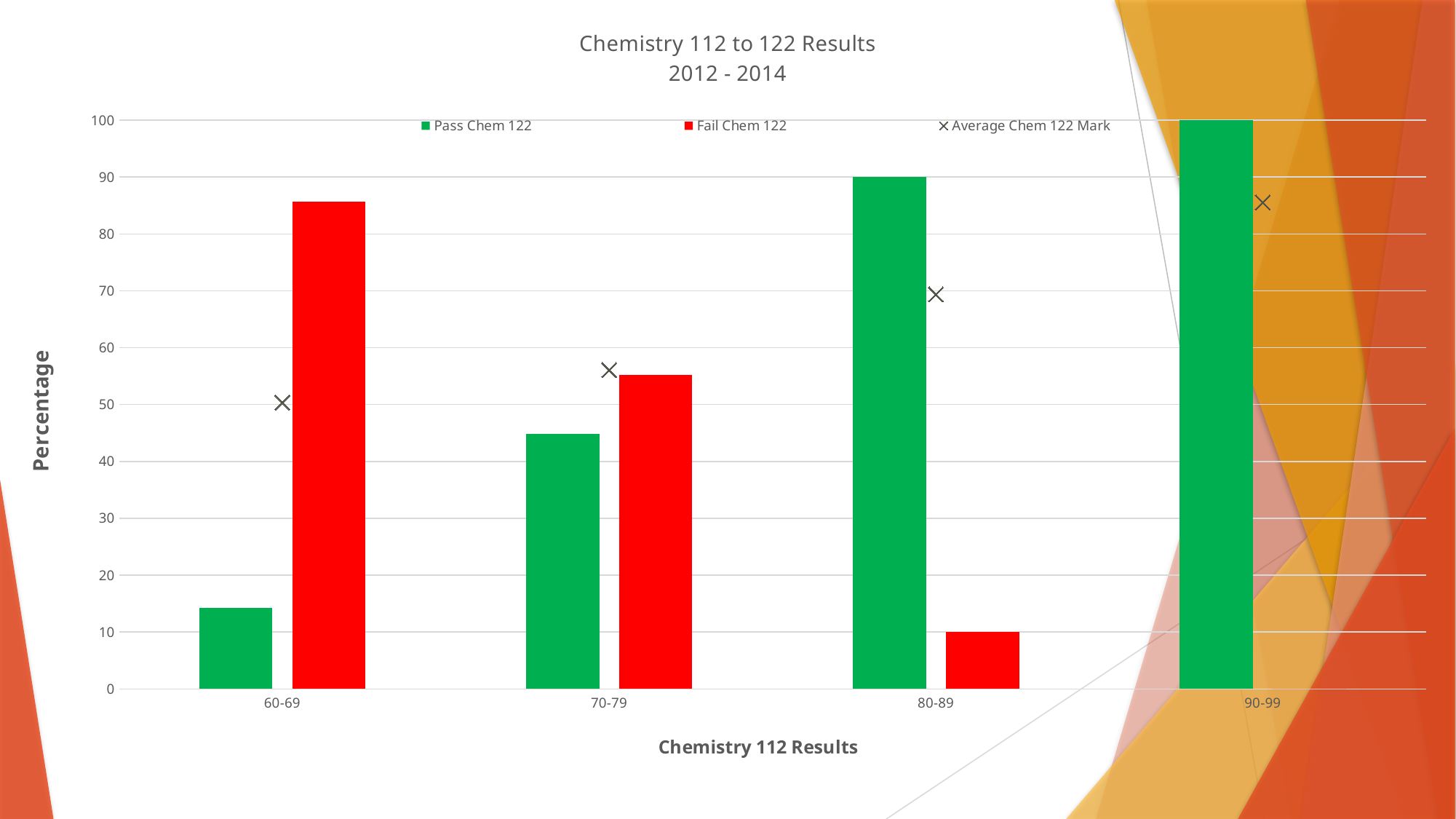
What is the Pass Chem 122 value for the 90-99 category? 100 Do the Pass Chem 122 values rise or fall from 60-69 to 90-99? rise In the 70-79 category, which is larger: Pass Chem 122 or Fail Chem 122? Fail Chem 122 How many series does the legend list? 3 How many categories are shown on the x axis? 4 Which category has the highest Fail Chem 122 value? 60-69 What is the Pass Chem 122 value for the 80-89 category? 90 Is the Fail Chem 122 value for 60-69 greater or less than 80? greater Which category has the highest Pass Chem 122 value? 90-99 What kind of chart is shown on the slide? combination bar and line chart What is the Fail Chem 122 value for the 80-89 category? 10 Which category has the lowest Pass Chem 122 value? 60-69